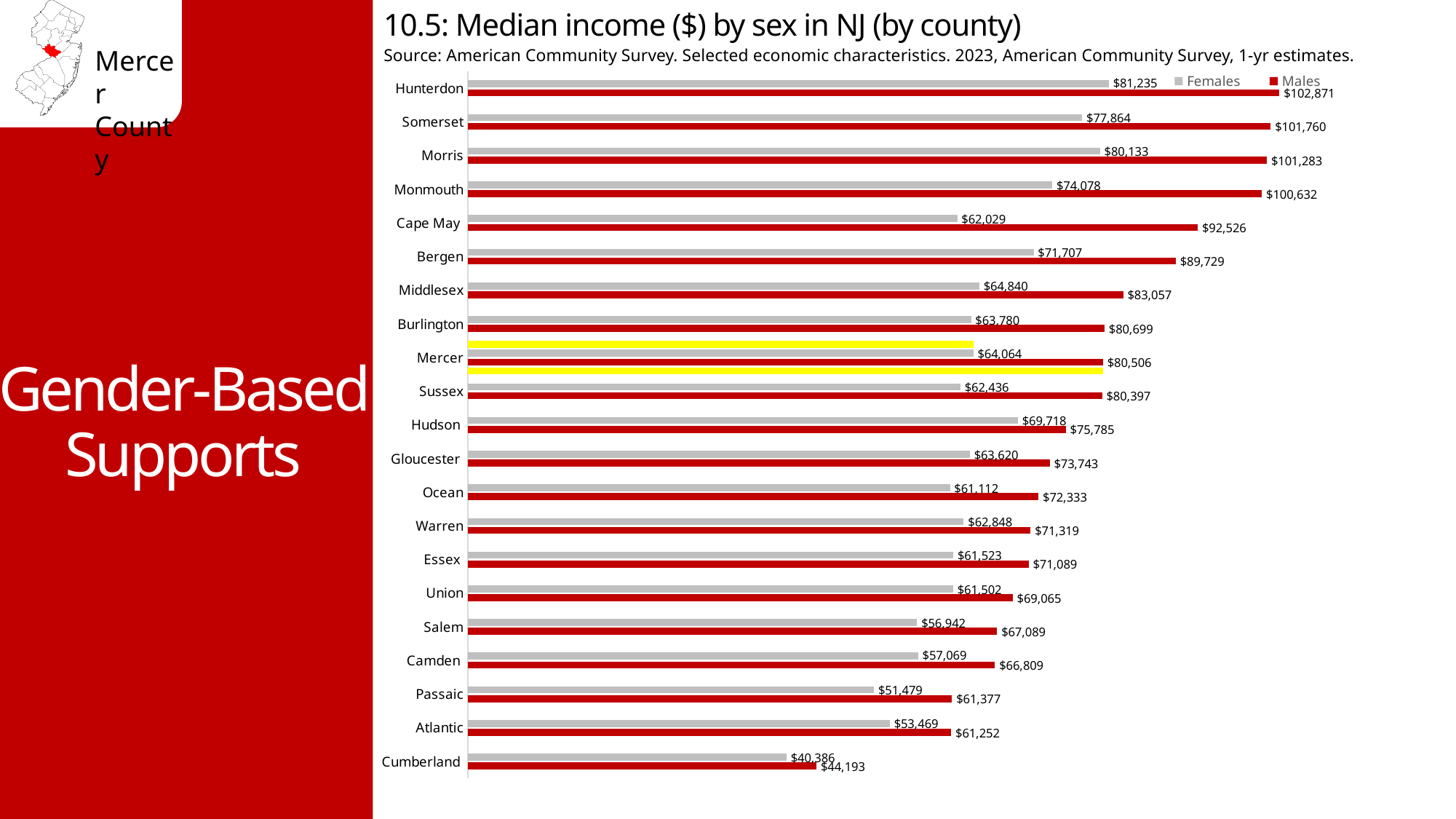
What is the difference between male and female median income in Cumberland County? $3,807 What is the median income for females in Mercer County? $64,064 What is the difference between male and female median income in Mercer County? $16,442 How many series does the legend list? 2 What is the median income for females in Hunterdon County? $81,235 What is the median income for males in Cape May County? $92,526 Which county has the lowest median income for females? Cumberland What is the median income for males in Mercer County? $80,506 How many counties are shown in the chart? 21 Which county has the highest median income for males? Hunterdon Which is larger, the female median income in Hudson County or in Bergen County? Bergen County What type of chart is shown on the slide? Bar chart